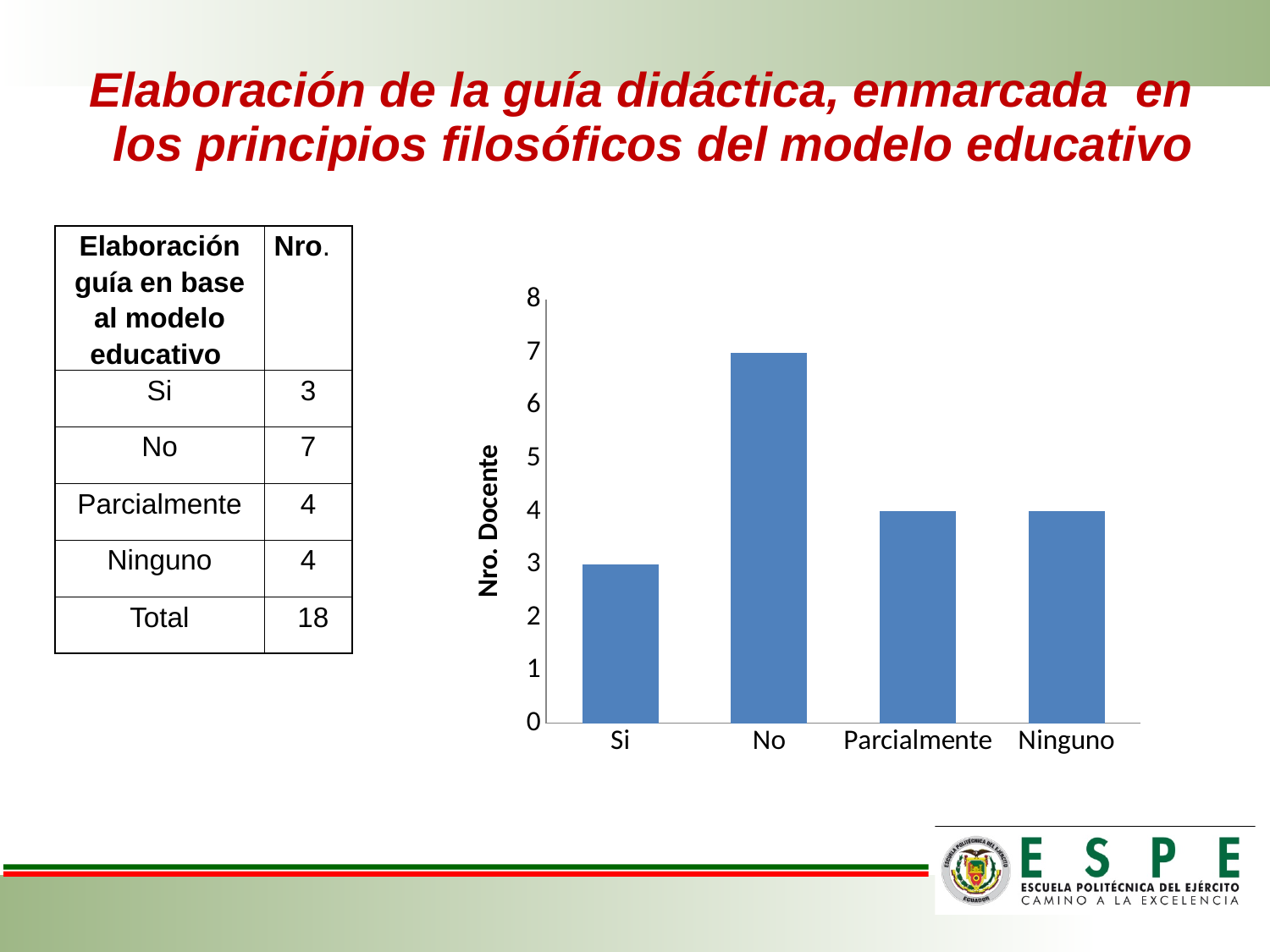
Which category has the lowest value in the chart? Si What is the value for Si in the chart? 3 How many categories are plotted on the x axis of the chart? 4 What kind of chart is shown on the slide? bar chart What is the difference between the values for No and Si? 4 Is the value for No greater or less than 5? greater What is the value for Ninguno in the chart? 4 What is the value for Parcialmente in the chart? 4 Which is larger, the value for No or the value for Parcialmente? No What is the value for No in the chart? 7 What is the label of the vertical axis of the chart? Nro. Docente Which category has the highest value in the chart? No